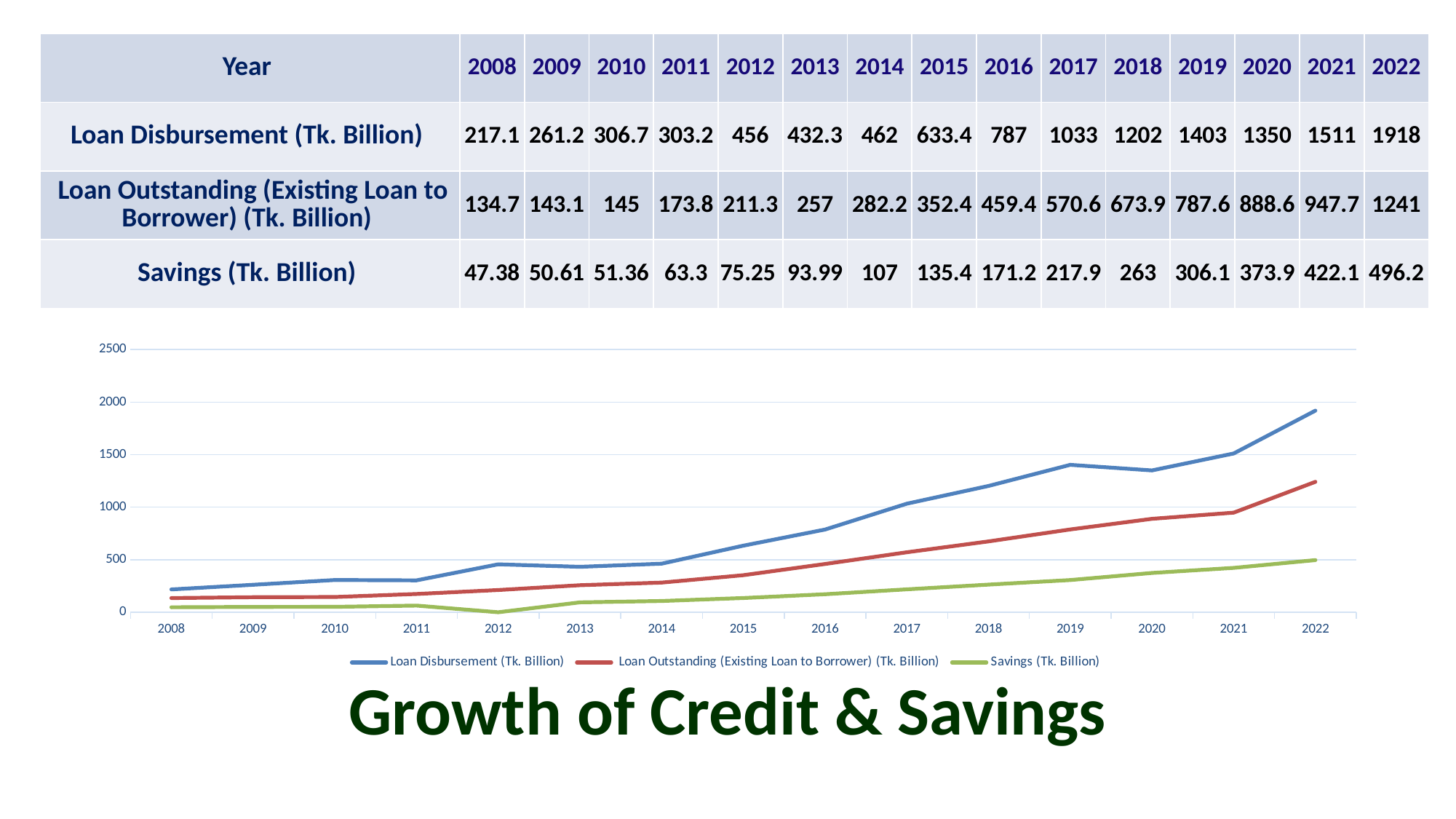
Does Loan Disbursement (Tk. Billion) generally rise or fall from 2008 to 2022? rise In which year is Savings (Tk. Billion) lowest according to the table? 2008 What is the title shown below the chart? Growth of Credit & Savings What is the Loan Disbursement (Tk. Billion) value for 2022? 1918 How many years are plotted along the x axis of the chart? 15 What is the Savings (Tk. Billion) value for 2019? 306.1 In which year is Loan Disbursement (Tk. Billion) highest? 2022 What is the difference between Loan Disbursement and Loan Outstanding in 2022? 677 What is the Loan Outstanding (Existing Loan to Borrower) (Tk. Billion) value for 2017? 570.6 Which is larger in 2020: Loan Disbursement or Loan Outstanding? Loan Disbursement How many series does the chart legend list? 3 What type of chart is shown on the slide? line chart